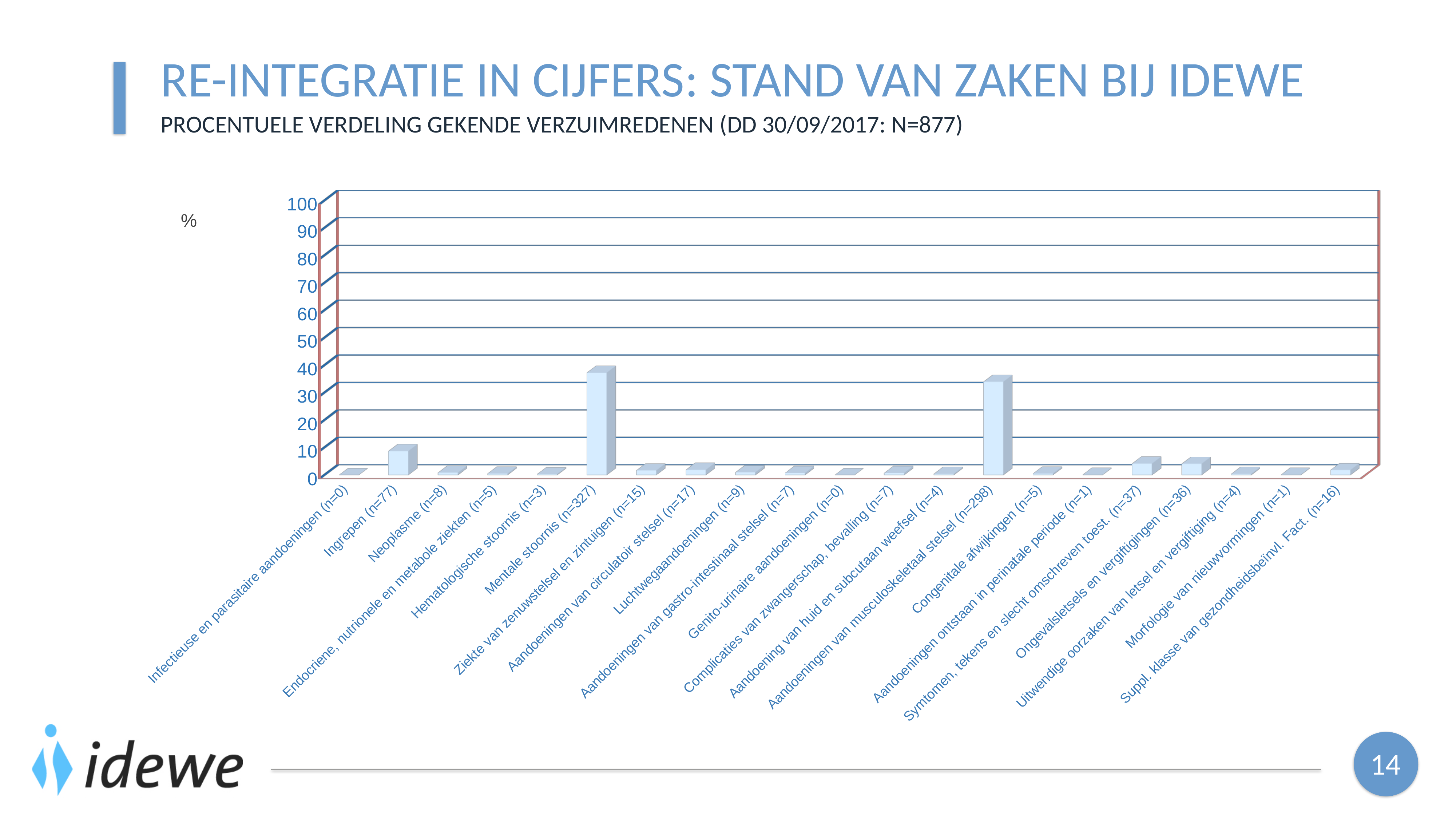
Is the value for Mentale stoornis greater or less than 30? greater Is the value for Ingrepen greater or less than 20? less Is the value for Mentale stoornis greater or less than 40? less Which is larger: the value for Ingrepen or the value for Neoplasme? Ingrepen Which category has the highest percentage? Mentale stoornis (n=327) What unit is indicated on the vertical axis of the chart? % According to the subtitle, what is the total N for the chart? 877 What kind of chart is shown on the slide? bar chart How many categories (verzuimredenen) are plotted along the x axis? 21 Which is larger: the value for Mentale stoornis or the value for Aandoeningen van musculoskeletaal stelsel? Mentale stoornis